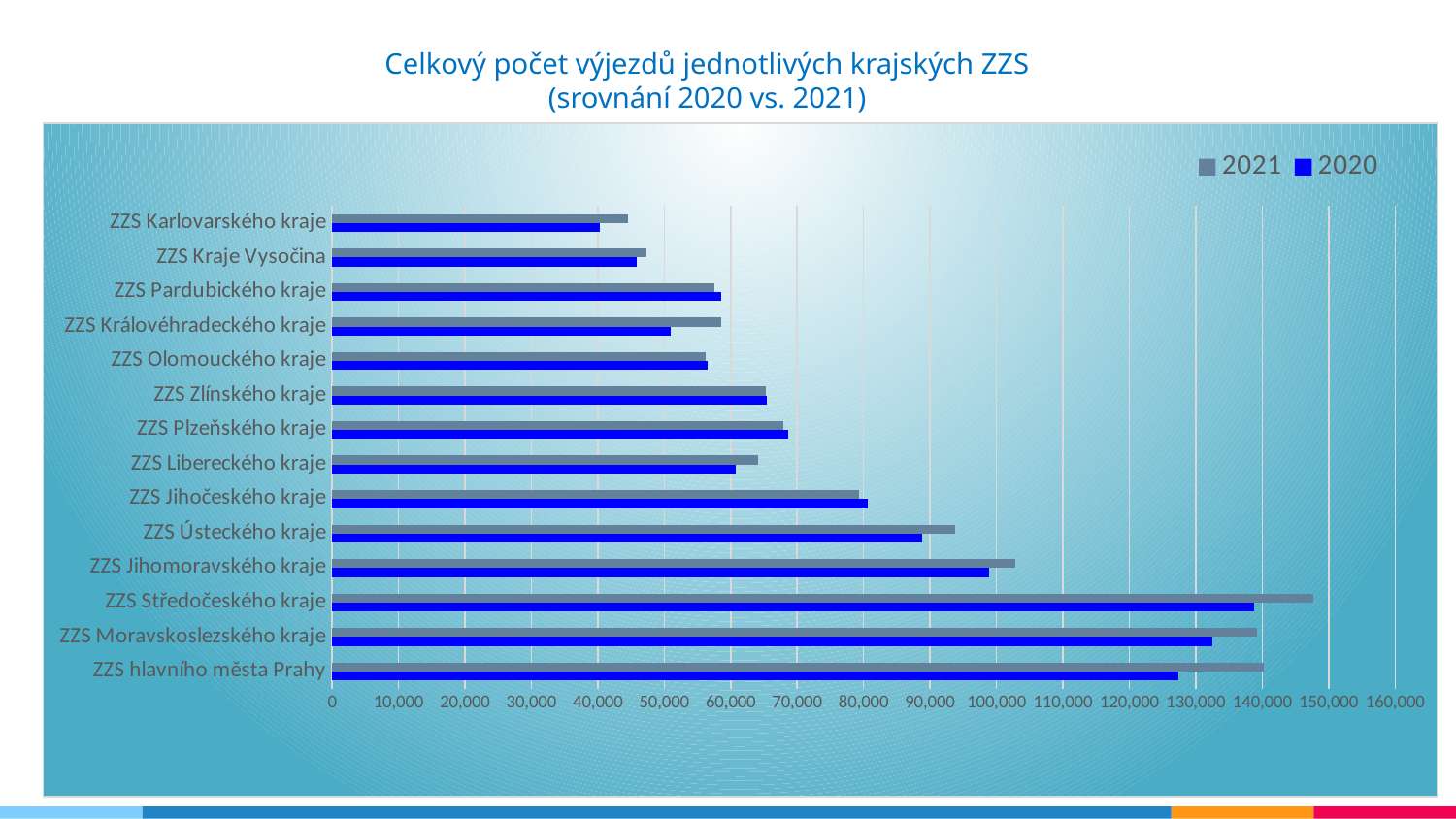
What kind of chart is shown on the slide? bar chart Which colour represents the 2020 series in the legend? blue Is the 2021 value for ZZS Ústeckého kraje greater or less than 90,000? greater Which ZZS has the highest value for 2021? ZZS Středočeského kraje Which ZZS has the lowest value for 2020? ZZS Karlovarského kraje How many series does the legend list? 2 How many regional ZZS organisations (categories) are shown on the chart? 14 Is the 2021 value for ZZS Karlovarského kraje greater or less than 50,000? less Is the 2020 value for ZZS Středočeského kraje greater or less than 130,000? greater For ZZS Královéhradeckého kraje, which year has the larger value, 2021 or 2020? 2021 For ZZS hlavního města Prahy, which year has the larger value, 2021 or 2020? 2021